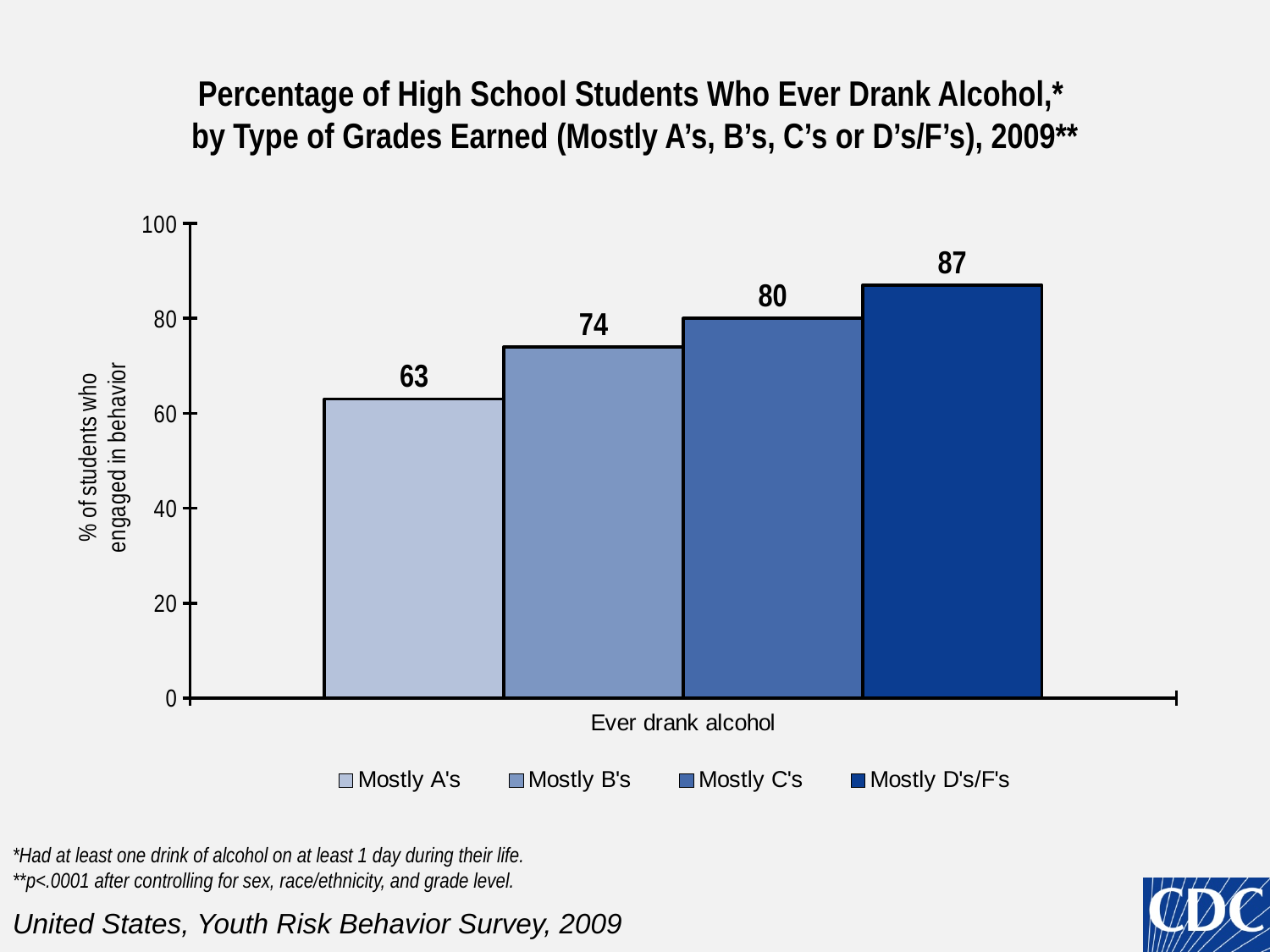
How many series does the legend list? 4 What is the value for Mostly D's/F's? 87 What is the label on the y axis? % of students who engaged in behavior What is the value for Mostly C's? 80 Which grade group has the highest percentage of students who ever drank alcohol? Mostly D's/F's Which grade group has the lowest percentage of students who ever drank alcohol? Mostly A's What kind of chart is shown on the slide? Bar chart What percentage of students with Mostly A's ever drank alcohol? 63 Do the values rise or fall going from Mostly A's to Mostly D's/F's? Rise What is the value for Mostly B's? 74 Which is larger, the value for Mostly B's or the value for Mostly C's? Mostly C's What is the difference between the values for Mostly D's/F's and Mostly A's? 24